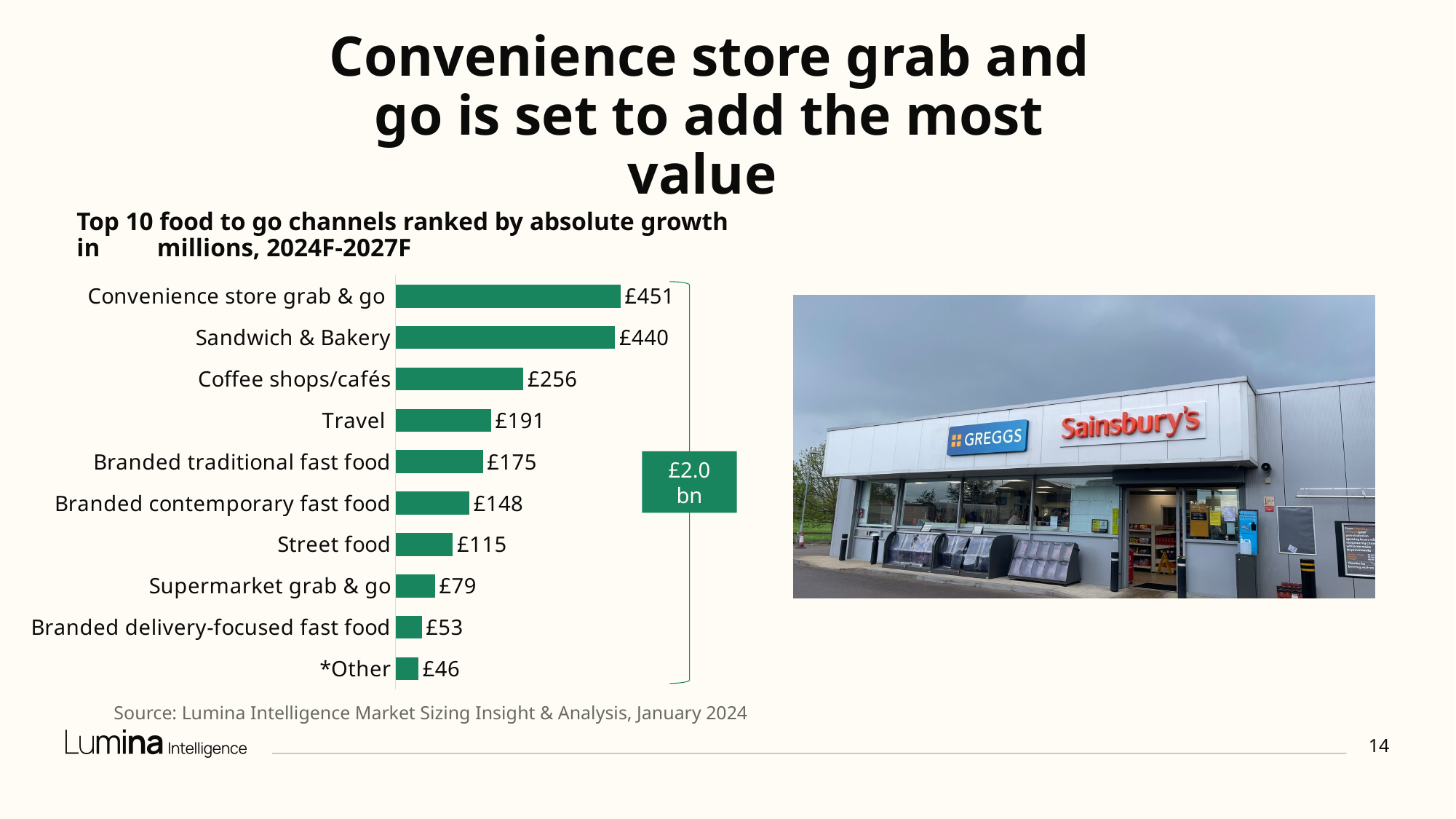
Which is larger, the value for Branded traditional fast food or Branded contemporary fast food? Branded traditional fast food What is the value shown for Supermarket grab & go? £79 How many channels are plotted in the chart? 10 Which channel has the highest absolute growth in the chart? Convenience store grab & go Which category has the lowest value in the chart? *Other What total value is shown in the green box next to the bracket spanning all the bars? £2.0 bn What is the value shown for Coffee shops/cafés? £256 What is the value shown for Branded delivery-focused fast food? £53 What kind of chart is shown on the slide? Bar chart What is the absolute growth value shown for Convenience store grab & go? £451 What is the difference between the values for Travel and Street food? £76 What is the difference between the values for Convenience store grab & go and Sandwich & Bakery? £11